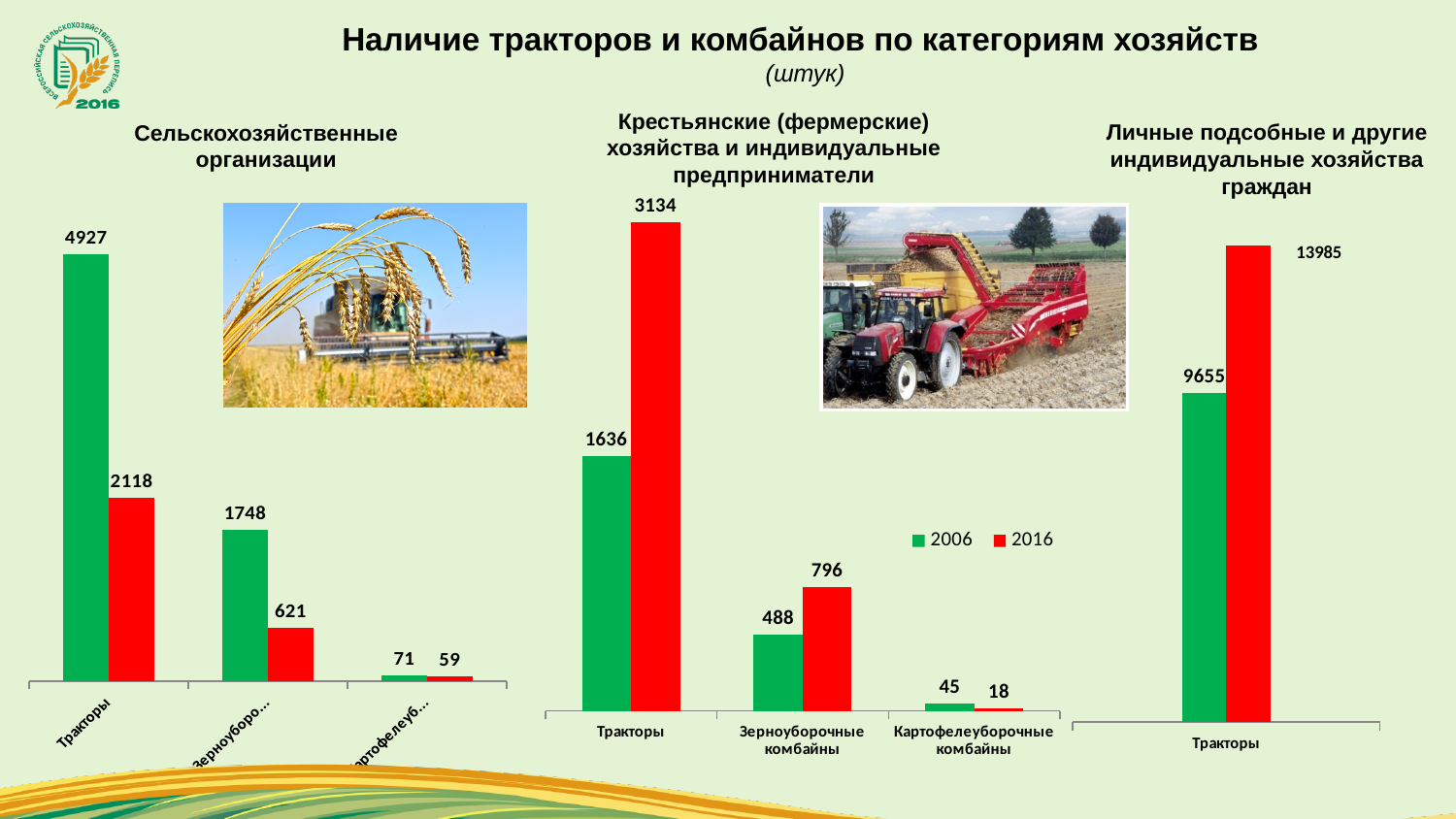
How many categories are shown on the chart 'Крестьянские (фермерские) хозяйства и индивидуальные предприниматели'? 3 On the chart 'Крестьянские (фермерские) хозяйства и индивидуальные предприниматели', what is the value for Зерноуборочные комбайны in 2006? 488 On the chart 'Личные подсобные и другие индивидуальные хозяйства граждан', what is the difference between the 2016 and 2006 values for Тракторы? 4330 On the chart 'Крестьянские (фермерские) хозяйства и индивидуальные предприниматели', which category has the lowest 2016 value? Картофелеуборочные комбайны On the chart 'Крестьянские (фермерские) хозяйства и индивидуальные предприниматели', which is larger for Картофелеуборочные комбайны: the 2006 value or the 2016 value? 2006 On the chart 'Сельскохозяйственные организации', what is the value for Тракторы in 2006? 4927 On the chart 'Личные подсобные и другие индивидуальные хозяйства граждан', what is the value for Тракторы in 2016? 13985 On the chart 'Крестьянские (фермерские) хозяйства и индивидуальные предприниматели', what is the value for Тракторы in 2016? 3134 What type of chart is used on this slide? Bar chart On the chart 'Сельскохозяйственные организации', what is the value for Тракторы in 2016? 2118 How many series does the legend list? 2 On the chart 'Сельскохозяйственные организации', what is the difference between the 2006 and 2016 values for Тракторы? 2809